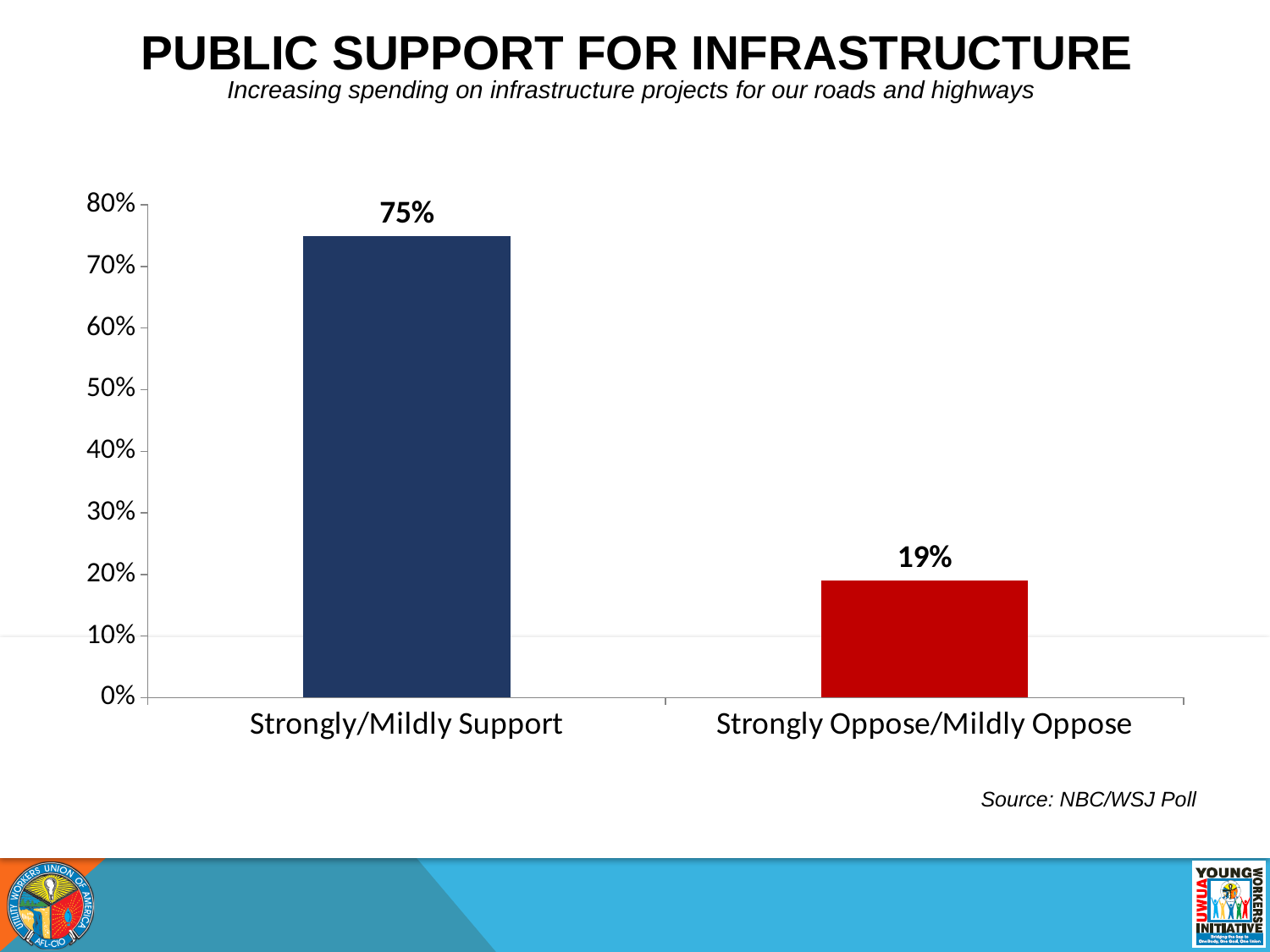
Is the value for Strongly/Mildly Support greater or less than 70%? greater What source is cited for the chart data? NBC/WSJ Poll What is the value for Strongly Oppose/Mildly Oppose? 19% What is the difference between the Strongly/Mildly Support and Strongly Oppose/Mildly Oppose values? 56% Which category has the lowest value? Strongly Oppose/Mildly Oppose Is the value for Strongly Oppose/Mildly Oppose greater or less than 20%? less What is the value for Strongly/Mildly Support? 75% What is the title of the slide? PUBLIC SUPPORT FOR INFRASTRUCTURE What kind of chart is shown on the slide? bar chart Which category has the highest value? Strongly/Mildly Support How many categories are shown on the chart? 2 Which is larger, the value for Strongly/Mildly Support or for Strongly Oppose/Mildly Oppose? Strongly/Mildly Support